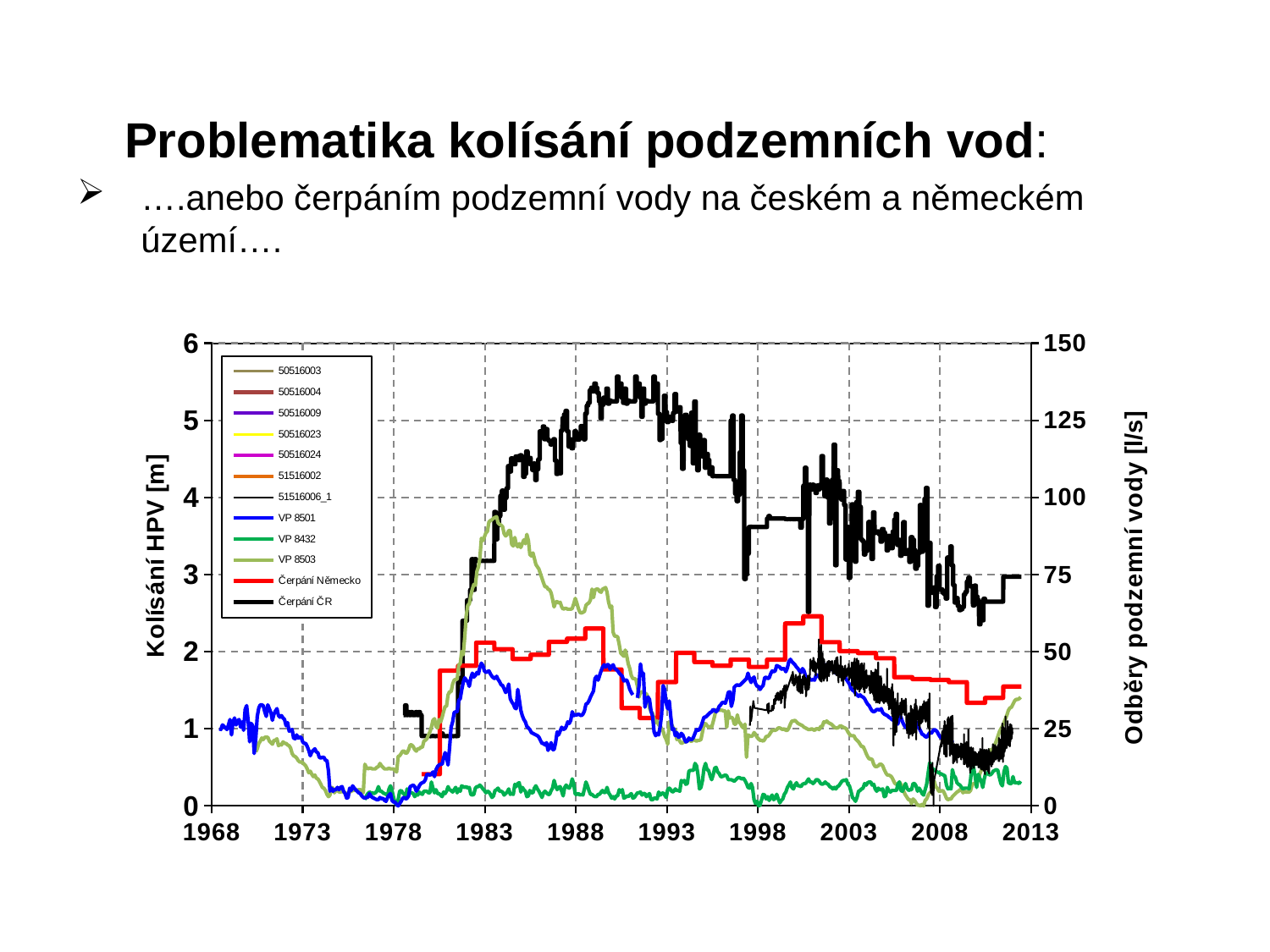
In 1984, which series is higher: VP 8503 or VP 8432? VP 8503 Is the value of VP 8432 in 1990 greater or less than 1 m? less Does the Čerpání ČR series generally rise or fall between 1993 and 2010? fall Is the value of Čerpání ČR around 1990 greater or less than 125 l/s? greater Around 1990, which series is higher on the right axis: Čerpání ČR or Čerpání Německo? Čerpání ČR What kind of chart is shown on the slide? line chart What is the label of the left vertical axis? Kolísání HPV [m] How many series does the legend list? 12 Is the value of Čerpání ČR in 2012 greater or less than 100 l/s? less What is the label of the right vertical axis? Odběry podzemní vody [l/s] Does the Čerpání ČR series generally rise or fall between 1980 and 1990? rise